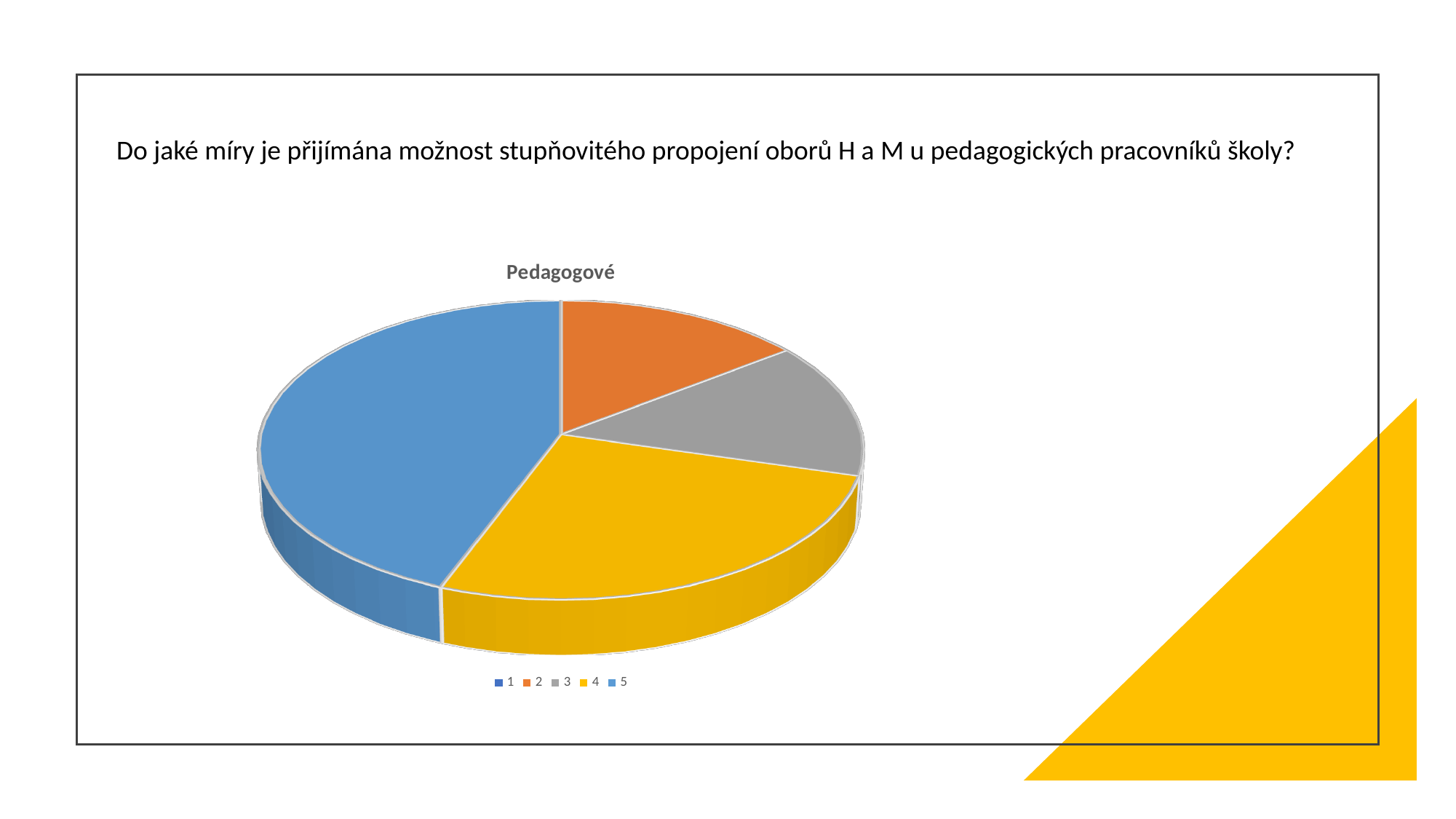
What is the title of the pie chart? Pedagogové Is the share of category 2 in the pie chart greater or less than 25%? less Which is larger in the pie chart, the slice for category 5 or the slice for category 4? 5 Which category has the second largest slice in the pie chart? 4 Which is larger in the pie chart, the slice for category 4 or the slice for category 2? 4 Which category has the largest slice in the pie chart? 5 What colour is the slice for category 4 in the pie chart? yellow Which is larger in the pie chart, the slice for category 5 or the slice for category 3? 5 What kind of chart is shown on the slide? pie chart Is the share of category 5 in the pie chart greater or less than 25%? greater How many entries does the legend of the pie chart list? 5